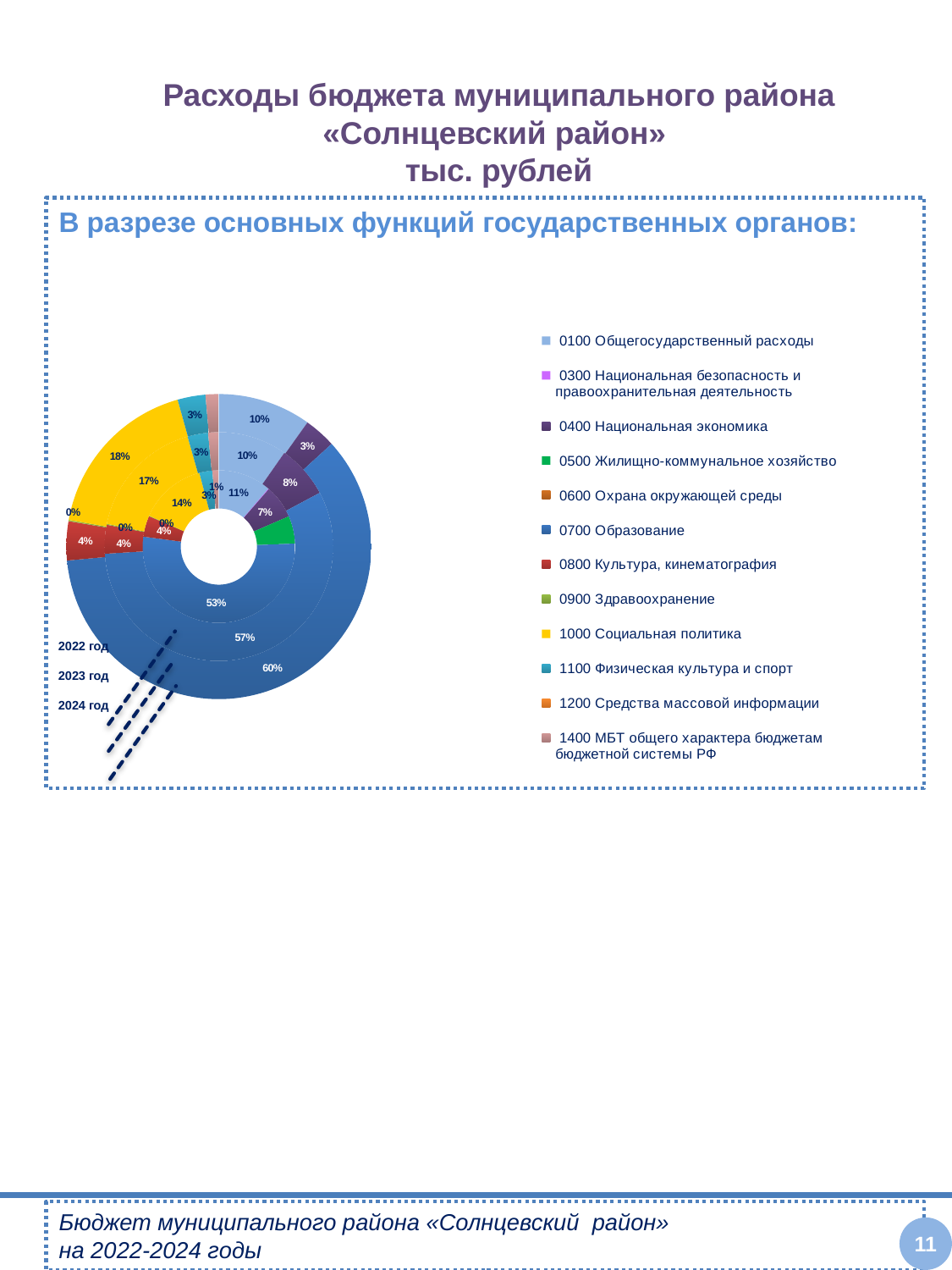
What is the share of 1000 Социальная политика in the inner ring (2022 год)? 14% Which is larger in the outer ring (2024 год): the share of 0700 Образование or the share of 1000 Социальная политика? 0700 Образование How many categories does the legend of the chart list? 12 Which category has the largest share in every ring of the chart? 0700 Образование Which colour represents 1000 Социальная политика in the chart legend? yellow What kind of chart is shown on the slide? doughnut (pie) chart By how many percentage points does the share of 0700 Образование in the outer ring (60%) exceed its share in the inner ring (53%)? 7 What is the share of 0700 Образование in the outer ring (2024 год)? 60% What is the share of 1000 Социальная политика in the outer ring (2024 год)? 18% What is the share of 0700 Образование in the inner ring (2022 год)? 53% What is the share of 0700 Образование in the middle ring (2023 год)? 57% Does the share of 0700 Образование rise or fall from the inner ring (2022) to the outer ring (2024)? rise